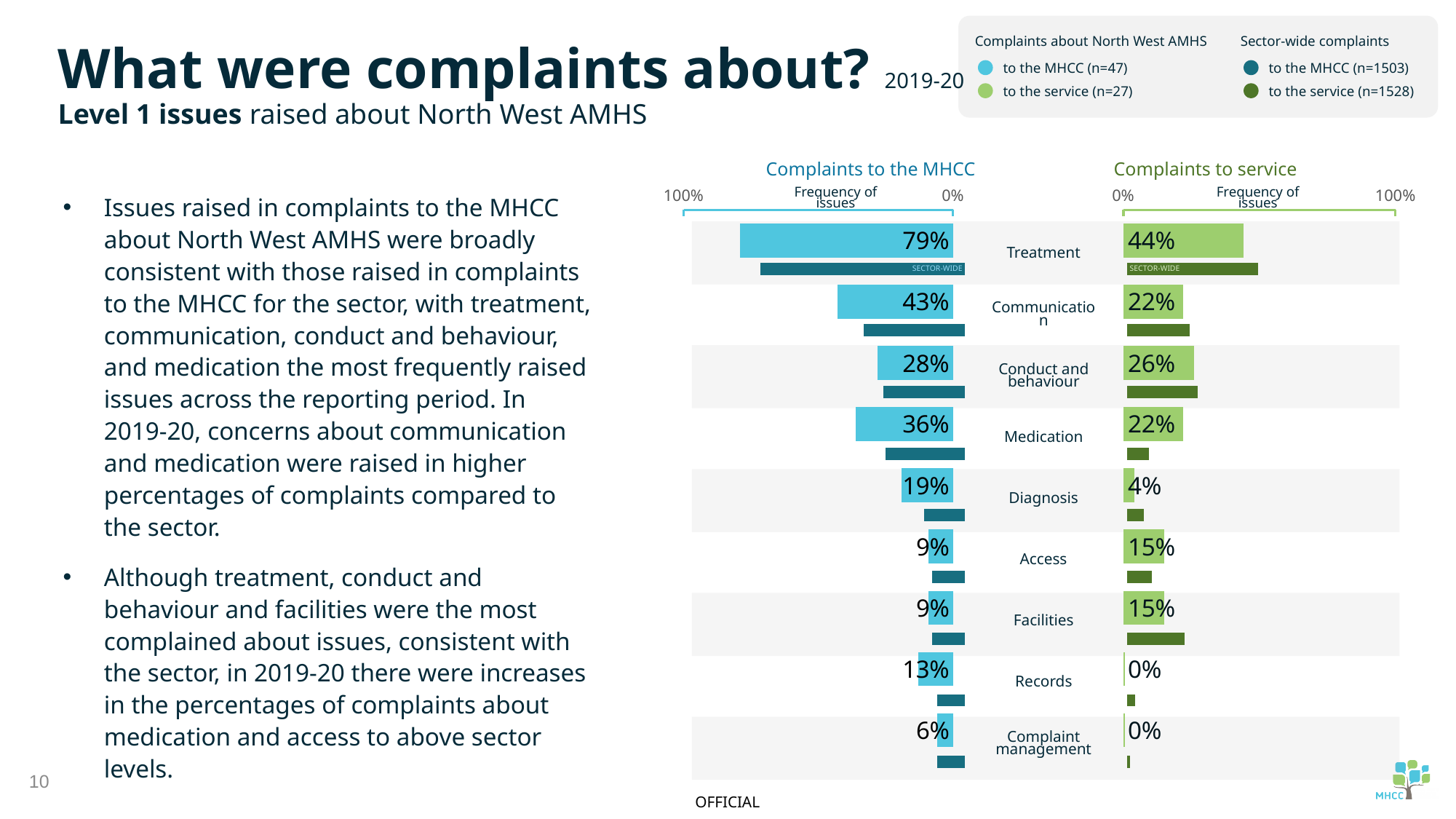
In the 'Complaints to the MHCC' chart, what is the value for Medication? 36% In the 'Complaints to the MHCC' chart, which issue has the lowest frequency? Complaint management In the 'Complaints to the MHCC' chart, which is larger: the value for Medication or the value for Conduct and behaviour? Medication In the 'Complaints to the MHCC' chart, what is the difference between the Treatment value and the Communication value? 36% In the 'Complaints to service' chart, what is the difference between the Treatment value and the Diagnosis value? 40% How many issue categories are listed in the 'Complaints to the MHCC' chart? 9 In the 'Complaints to service' chart, what is the value for Conduct and behaviour? 26% How many entries does the legend at the top right of the slide list? 4 In the 'Complaints to service' chart, which is larger: the value for Access or the value for Diagnosis? Access In the 'Complaints to the MHCC' chart, what percentage of complaints raised Treatment as an issue? 79% In the 'Complaints to service' chart, which issue has the highest frequency? Treatment What kind of chart is the 'Complaints to service' chart? Bar chart